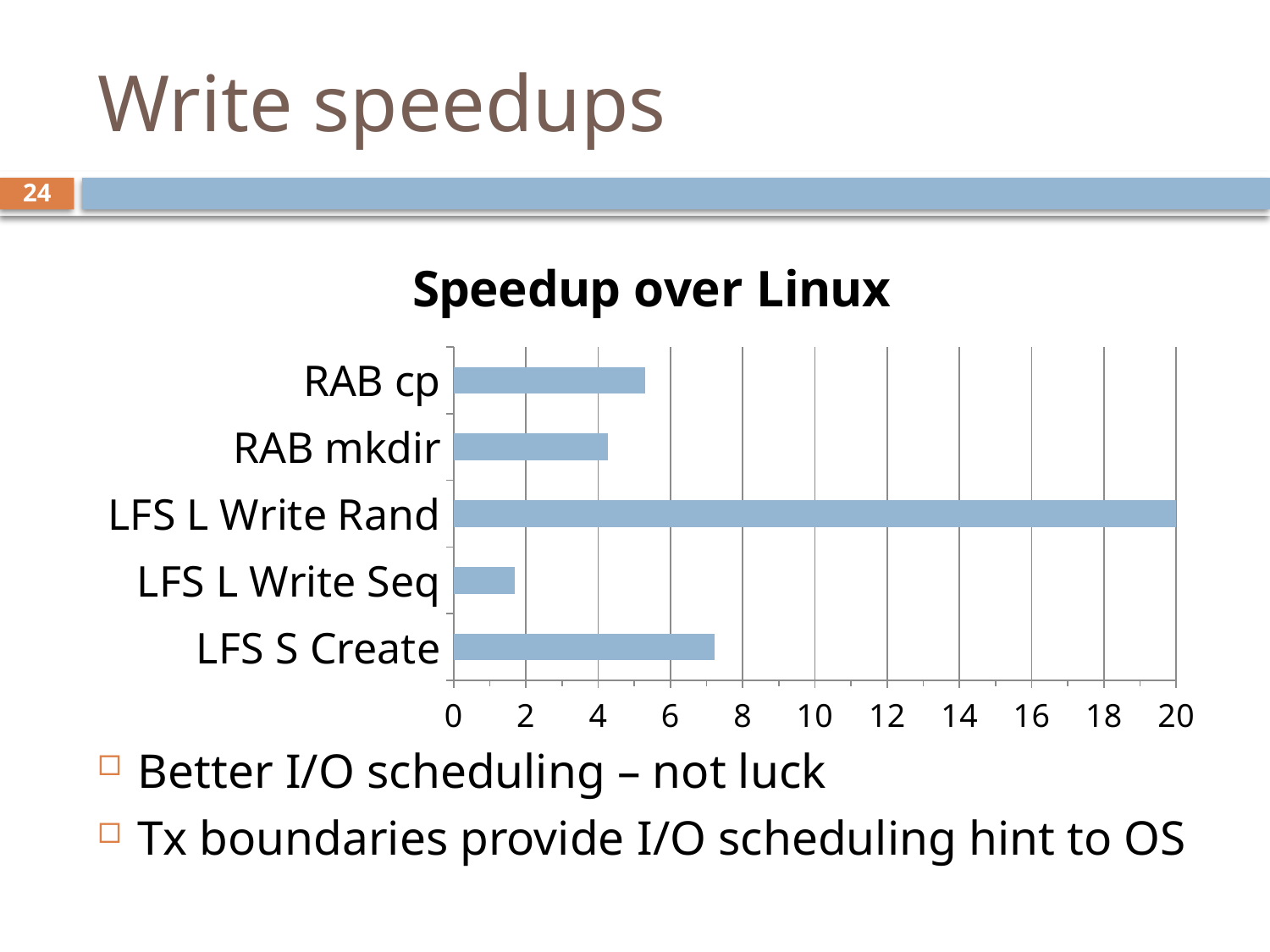
Which category has the highest speedup over Linux? LFS L Write Rand Is the value for RAB cp greater or less than 4? greater Is the value for LFS S Create greater or less than 6? greater What is the title of the chart? Speedup over Linux Is the value for RAB mkdir greater or less than 6? less How many categories are plotted in the chart? 5 What kind of chart is shown on the slide? bar chart Which is larger, the value for LFS S Create or the value for RAB cp? LFS S Create Which is larger, the value for RAB mkdir or the value for LFS L Write Seq? RAB mkdir Which category has the lowest speedup over Linux? LFS L Write Seq